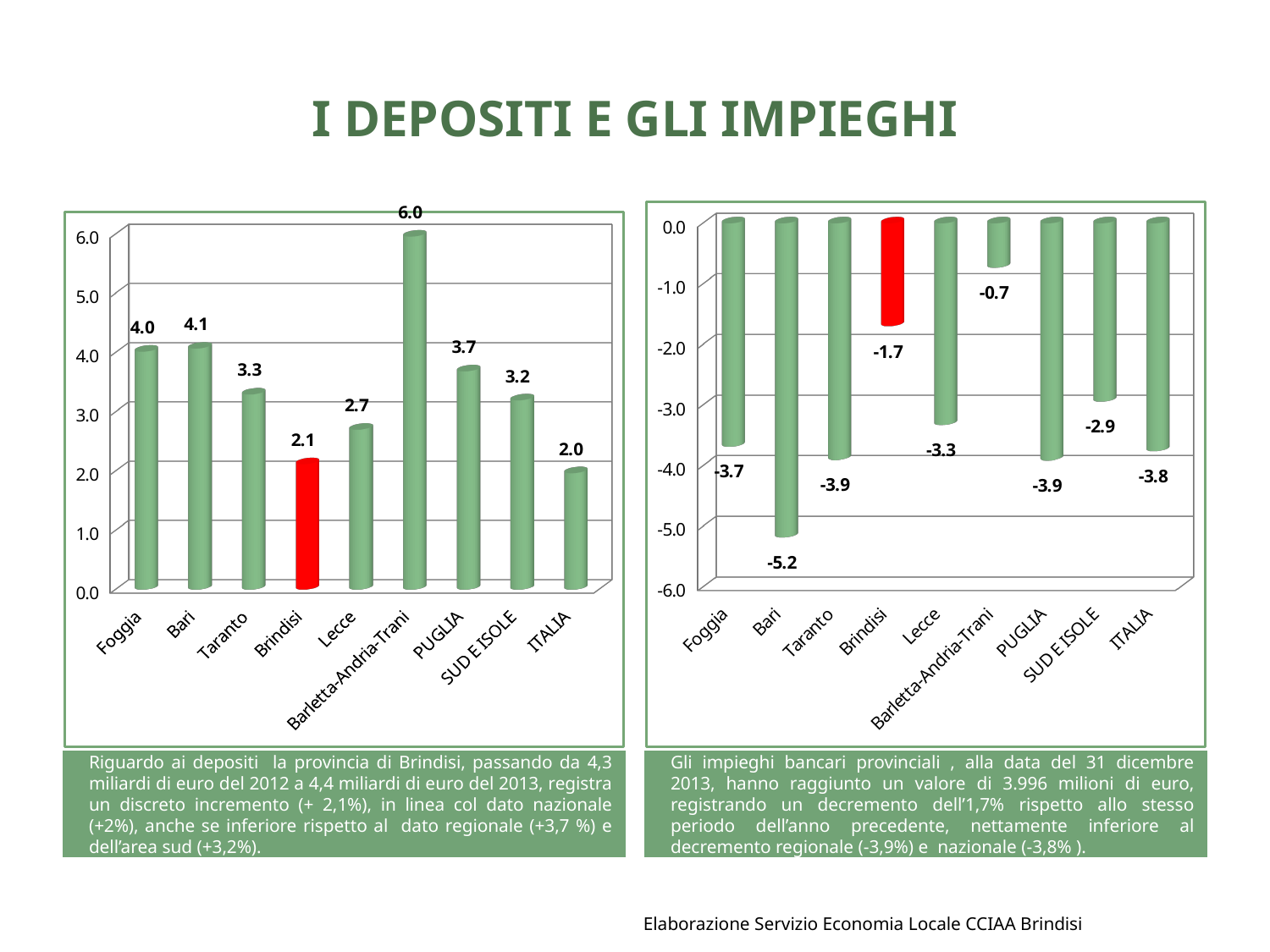
In the left chart, what is the value for Brindisi? 2.1 In the left chart, which category has the lowest value? ITALIA In the left chart, what is the difference between the values for PUGLIA and Brindisi? 1.6 In the right chart, which category has the lowest (most negative) value? Bari In the right chart, what is the value for SUD E ISOLE? -2.9 What kind of chart is the left chart? Bar chart In the left chart, how many categories are shown on the x axis? 9 In the right chart, which is larger, the value for Brindisi or the value for ITALIA? Brindisi In the right chart, which category has the highest (least negative) value? Barletta-Andria-Trani In the right chart, what is the value for Bari? -5.2 In the left chart, which category has the highest value? Barletta-Andria-Trani In the left chart, which bar is coloured red? Brindisi